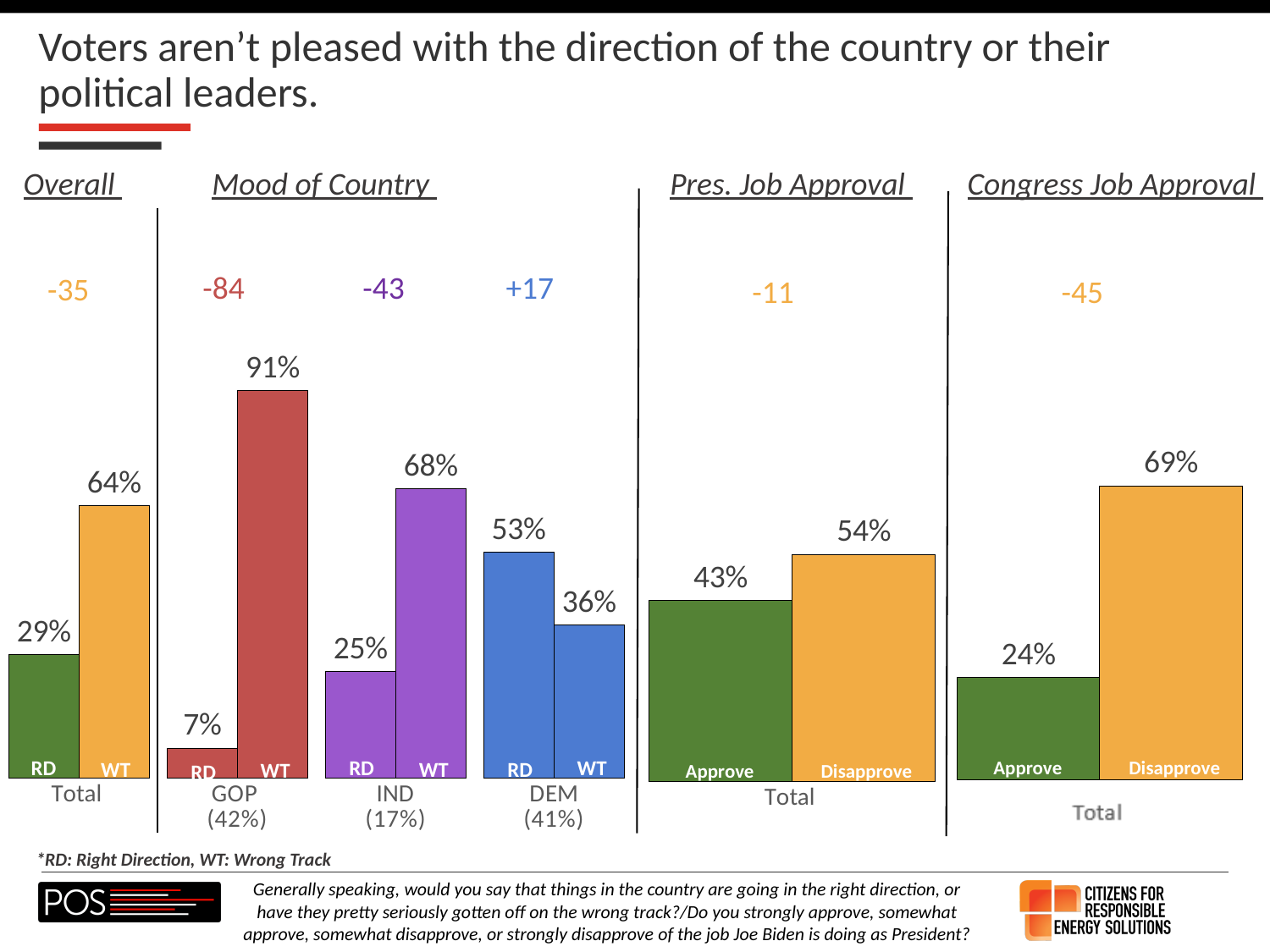
In the Mood of Country chart, what is the Right Direction (RD) value for GOP voters? 7% In the Mood of Country chart, which party group has the lowest Right Direction (RD) value? GOP What type of chart is used for the Pres. Job Approval data? Bar chart In the Pres. Job Approval chart, what percentage of voters disapprove? 54% Which is larger: the Approve value in the Pres. Job Approval chart or the Approve value in the Congress Job Approval chart? Pres. Job Approval In the Congress Job Approval chart, what is the difference between the Disapprove and Approve values? 45 In the Mood of Country chart, what is the Wrong Track (WT) value for IND voters? 68% In the Congress Job Approval chart, what percentage of voters approve? 24% In the Overall mood of country chart, what percentage of voters say the country is on the wrong track (WT)? 64% How many party groups are shown in the Mood of Country chart? 3 In the Mood of Country chart, what is the difference between the DEM Right Direction (RD) value and the DEM Wrong Track (WT) value? 17 In the Mood of Country chart, which party group has the highest Wrong Track (WT) value? GOP